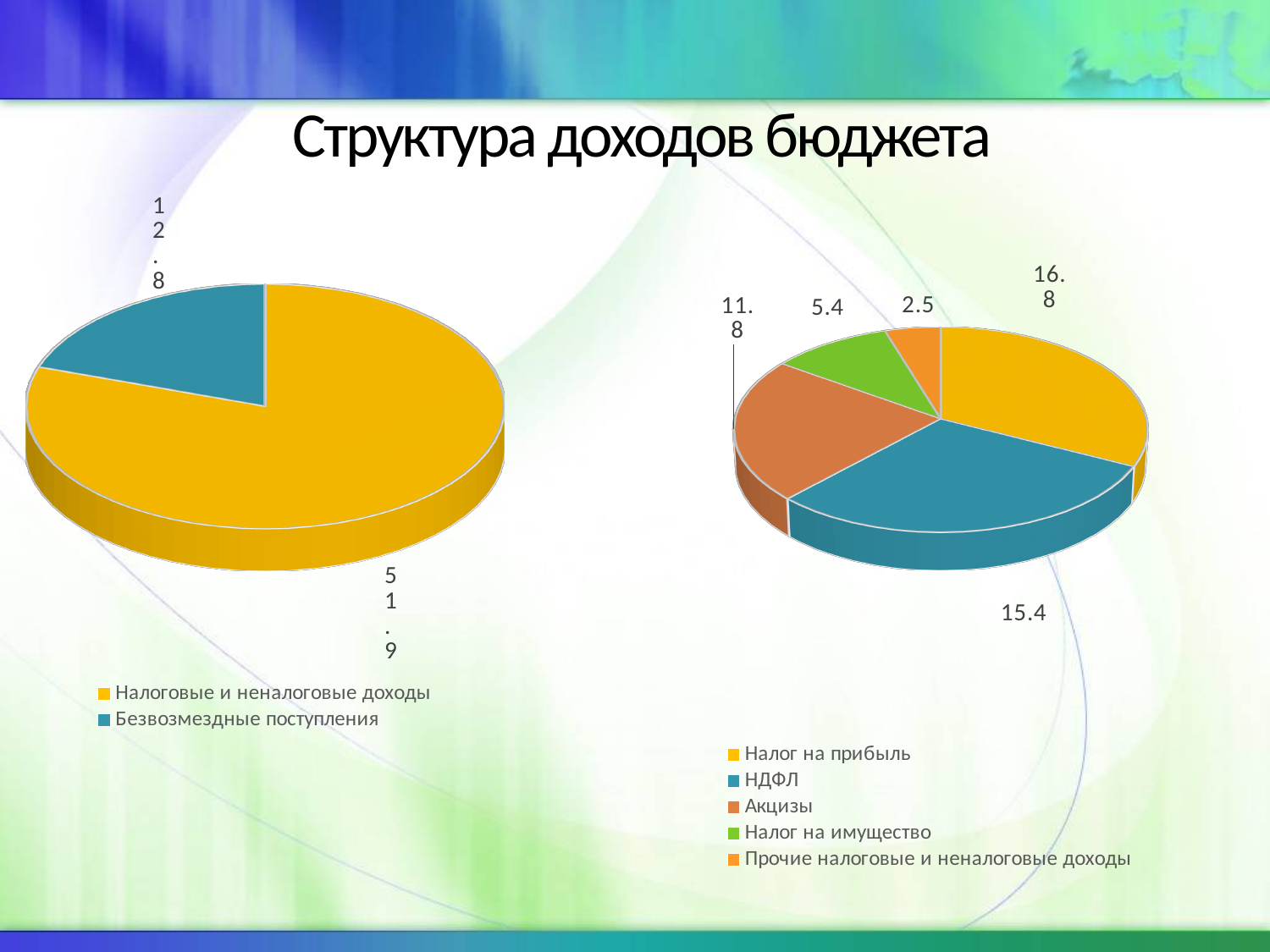
In the right pie chart, what is the value for Налог на прибыль? 16.8 In the right pie chart, what is the value for Акцизы? 11.8 In the left pie chart, how many slices are there? 2 What type of chart is shown on the right side of the slide? Pie chart In the right pie chart, how many categories does the legend list? 5 In the left pie chart, what is the difference between Налоговые и неналоговые доходы and Безвозмездные поступления? 39.1 In the right pie chart, which is larger: Налог на имущество or Акцизы? Акцизы In the left pie chart, what is the value for Безвозмездные поступления? 12.8 In the right pie chart, what is the value for НДФЛ? 15.4 In the right pie chart, which category has the smallest value? Прочие налоговые и неналоговые доходы In the left pie chart, what is the value for Налоговые и неналоговые доходы? 51.9 In the right pie chart, which category has the largest value? Налог на прибыль